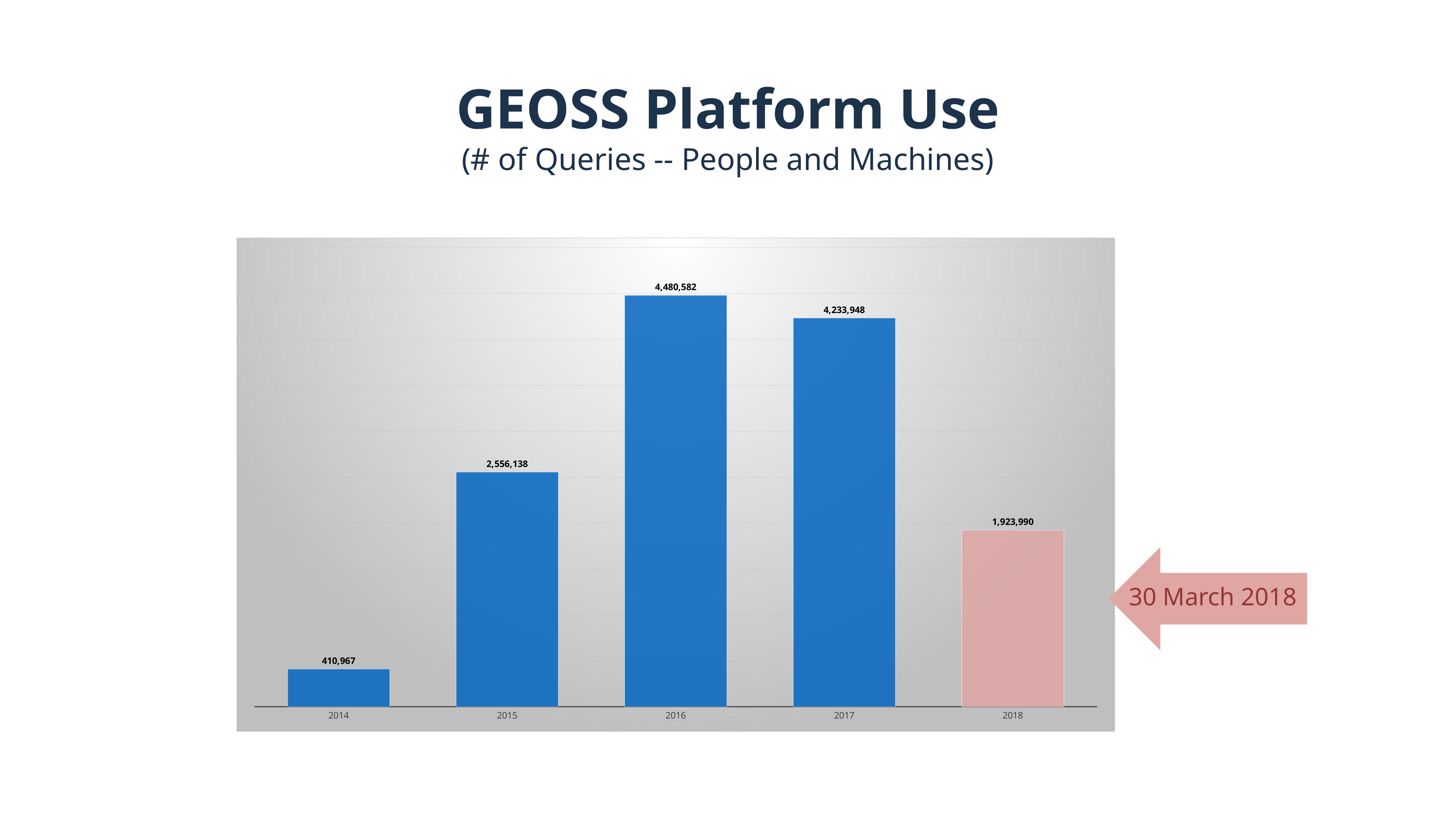
What value is labelled on the 2018 bar? 1,923,990 What is the difference between the 2015 and 2014 values? 2,145,171 What is the number of queries shown for 2014? 410,967 Which year has the highest number of queries? 2016 Do the values rise or fall from 2014 to 2016? Rise How many years are shown on the x axis? 5 Which year has the lowest number of queries? 2014 What is the number of queries shown for 2016? 4,480,582 What is the difference between the 2016 and 2017 values? 246,634 What is the number of queries shown for 2015? 2,556,138 Which year has the larger value, 2017 or 2018? 2017 What kind of chart is shown on the slide? Bar chart